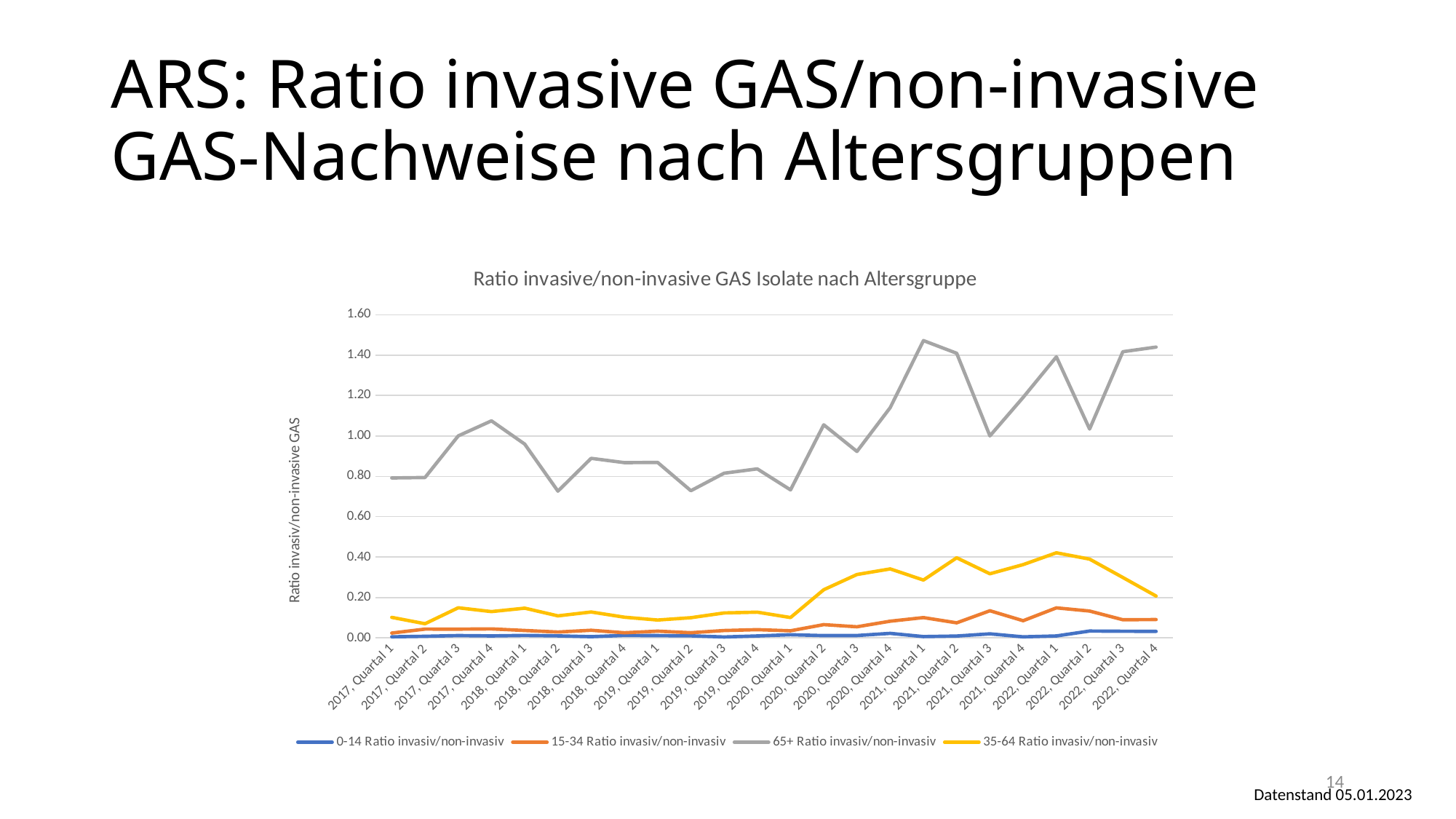
Is the value for 65+ Ratio invasiv/non-invasiv at 2018, Quartal 2 greater or less than 0.80? less For the 65+ series, is the value at 2020, Quartal 2 or at 2020, Quartal 3 larger? 2020, Quartal 2 Does the 35-64 Ratio invasiv/non-invasiv series rise or fall from 2020, Quartal 1 to 2020, Quartal 4? rise What is the title of the y axis? Ratio invasiv/non-invasive GAS How many series does the legend list? 4 Which age group series has the highest ratio values across the whole period? 65+ Ratio invasiv/non-invasiv Which age group series has the lowest ratio values across the whole period? 0-14 Ratio invasiv/non-invasiv How many quarters are plotted along the x axis? 24 Is the value for 65+ Ratio invasiv/non-invasiv at 2021, Quartal 1 greater or less than 1.20? greater Is the value for 35-64 Ratio invasiv/non-invasiv at 2017, Quartal 2 greater or less than 0.20? less What kind of chart is shown on the slide? line chart